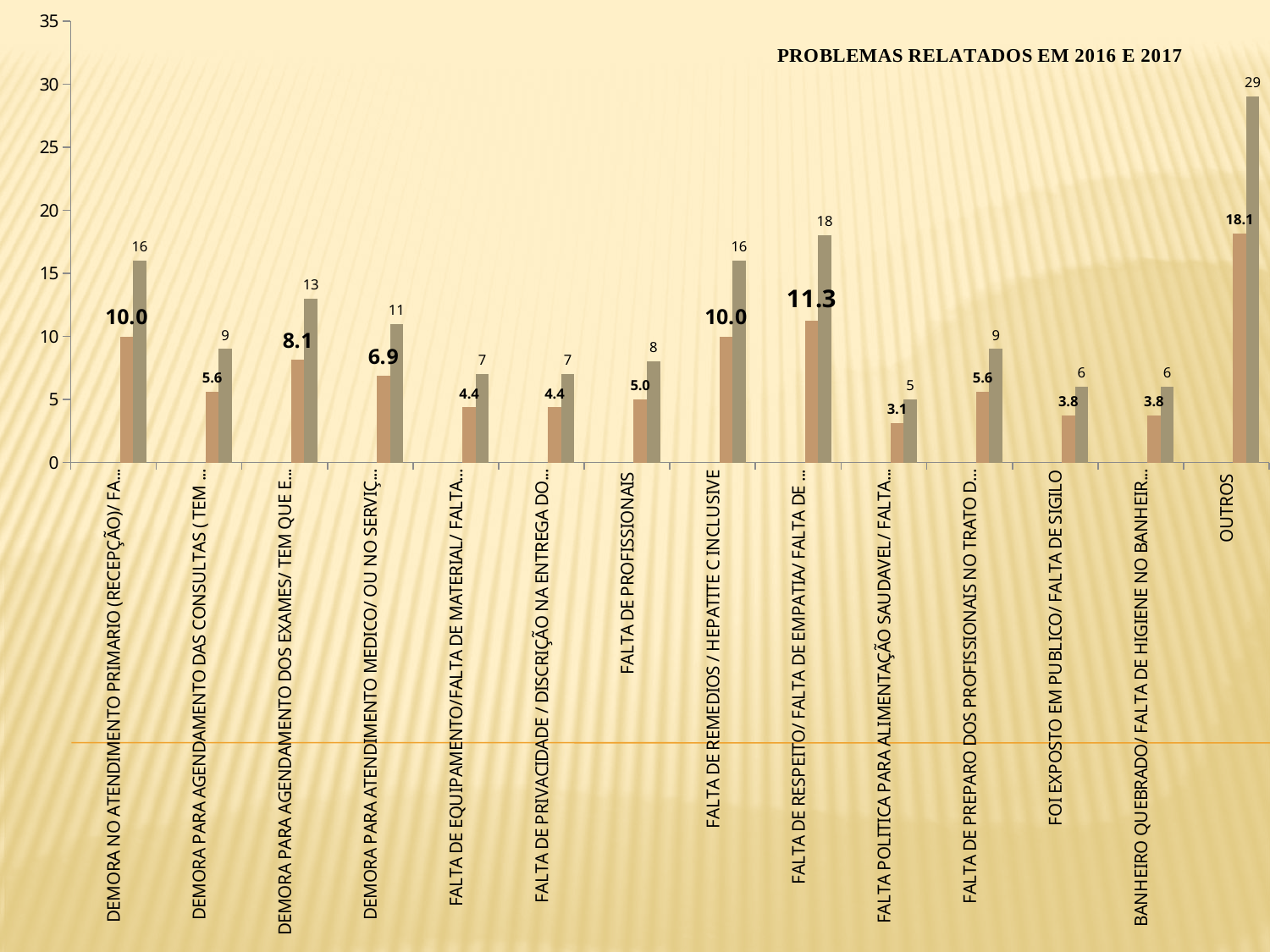
What is the value of the brown bar for FALTA DE PROFISSIONAIS? 5.0 Is the gray bar for OUTROS greater or less than 25? greater Which category has the highest gray bar? OUTROS Which is larger for FALTA DE PROFISSIONAIS: the brown bar or the gray bar? the gray bar What kind of chart is shown on the slide? bar chart What is the value of the gray bar for FOI EXPOSTO EM PUBLICO/ FALTA DE SIGILO? 6 What is the value of the brown bar for OUTROS? 18.1 What is the difference between the gray bar and the brown bar for OUTROS? 10.9 What is the value of the gray bar for FALTA DE REMEDIOS / HEPATITE C INCLUSIVE? 16 How many categories are shown on the x axis? 14 What is the title of the chart? PROBLEMAS RELATADOS EM 2016 E 2017 What is the value of the gray bar for OUTROS? 29